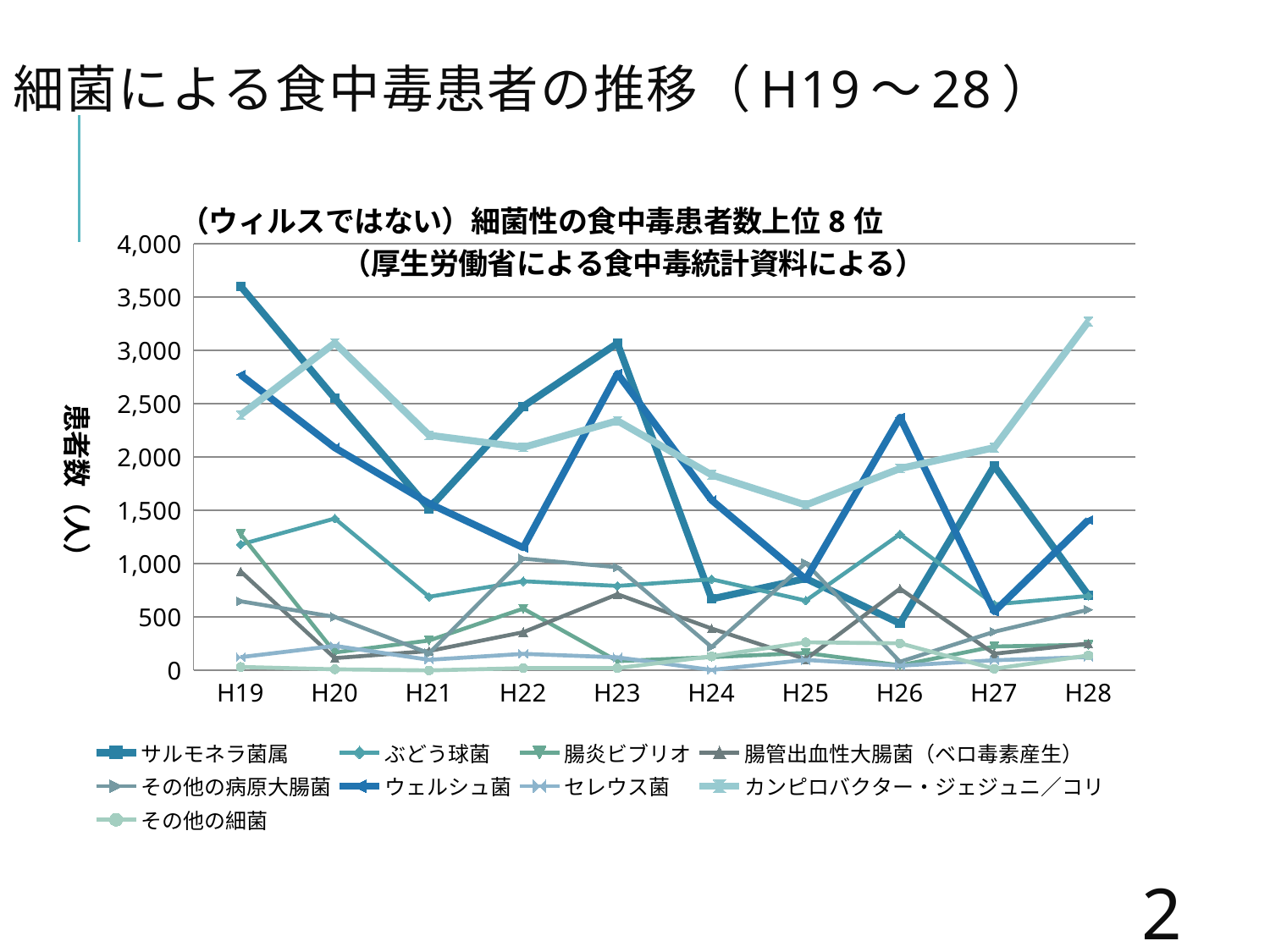
What kind of chart is shown on the slide? line chart How many years (points) are shown along the x axis? 10 In which year is the value for サルモネラ菌属 highest? H19 Does the value for サルモネラ菌属 rise or fall from H19 to H21? fall How many series does the legend list? 9 Is the value for カンピロバクター・ジェジュニ／コリ in H28 greater or less than 3,000? greater In which year is the value for カンピロバクター・ジェジュニ／コリ highest? H28 In H28, which is larger: カンピロバクター・ジェジュニ／コリ or サルモネラ菌属? カンピロバクター・ジェジュニ／コリ Is the value for ウェルシュ菌 in H22 greater or less than 1,500? less Is the value for サルモネラ菌属 in H26 greater or less than 1,000? less What is the label on the y axis? 患者数（人）